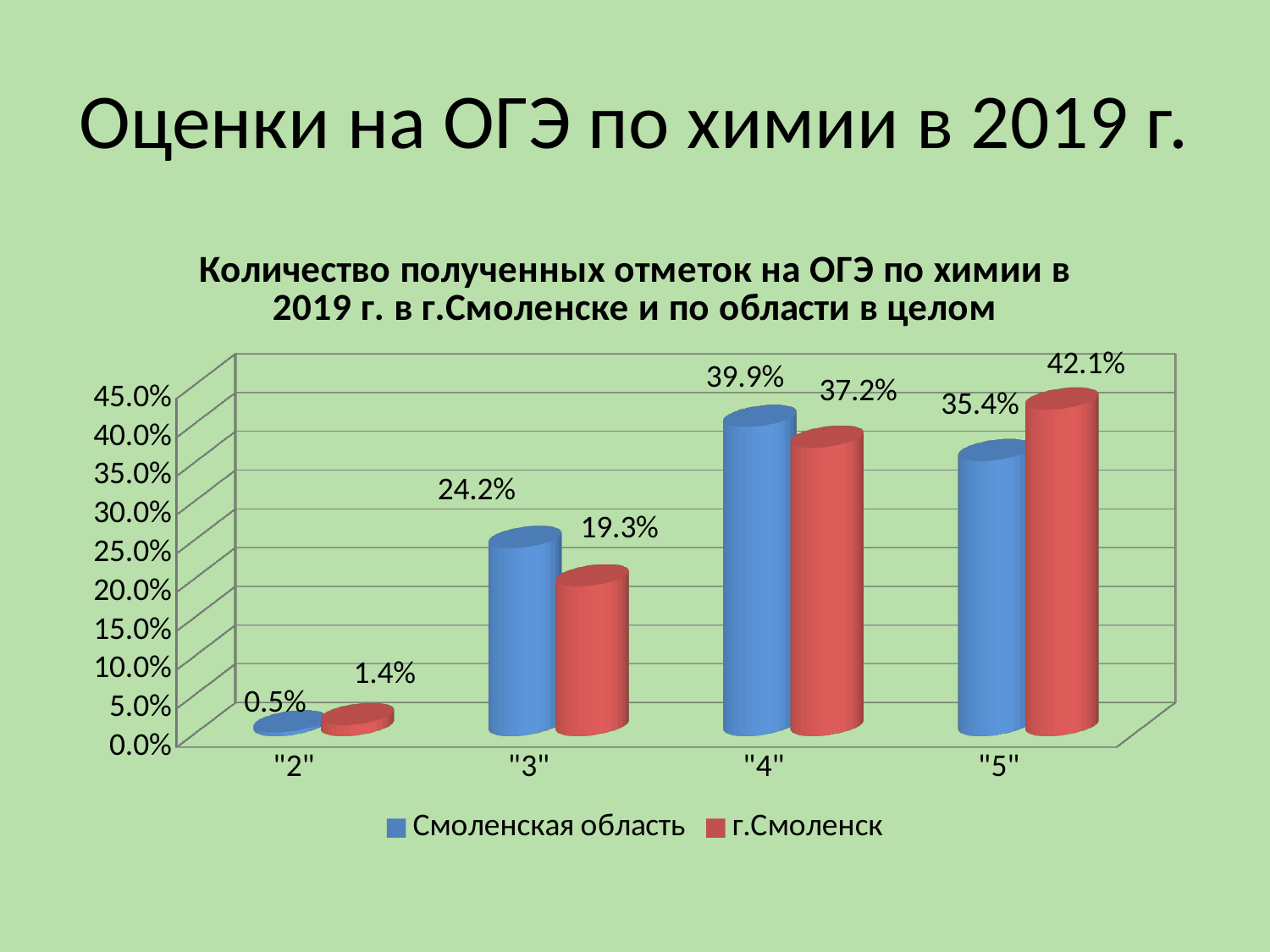
Which is larger for "5": Смоленская область or г.Смоленск? г.Смоленск Which category has the lowest value in the Смоленская область series? "2" What is the value for "4" in the Смоленская область series? 39.9% What is the value for "2" in the г.Смоленск series? 1.4% Which category has the highest value in the г.Смоленск series? "5" What is the value for "5" in the г.Смоленск series? 42.1% How many series does the legend list? 2 What kind of chart is shown on the slide? Bar chart How many categories are shown on the x axis? 4 Which series is shown in red? г.Смоленск What is the value for "3" in the Смоленская область series? 24.2% What is the difference between the Смоленская область and г.Смоленск values for "3"? 4.9%